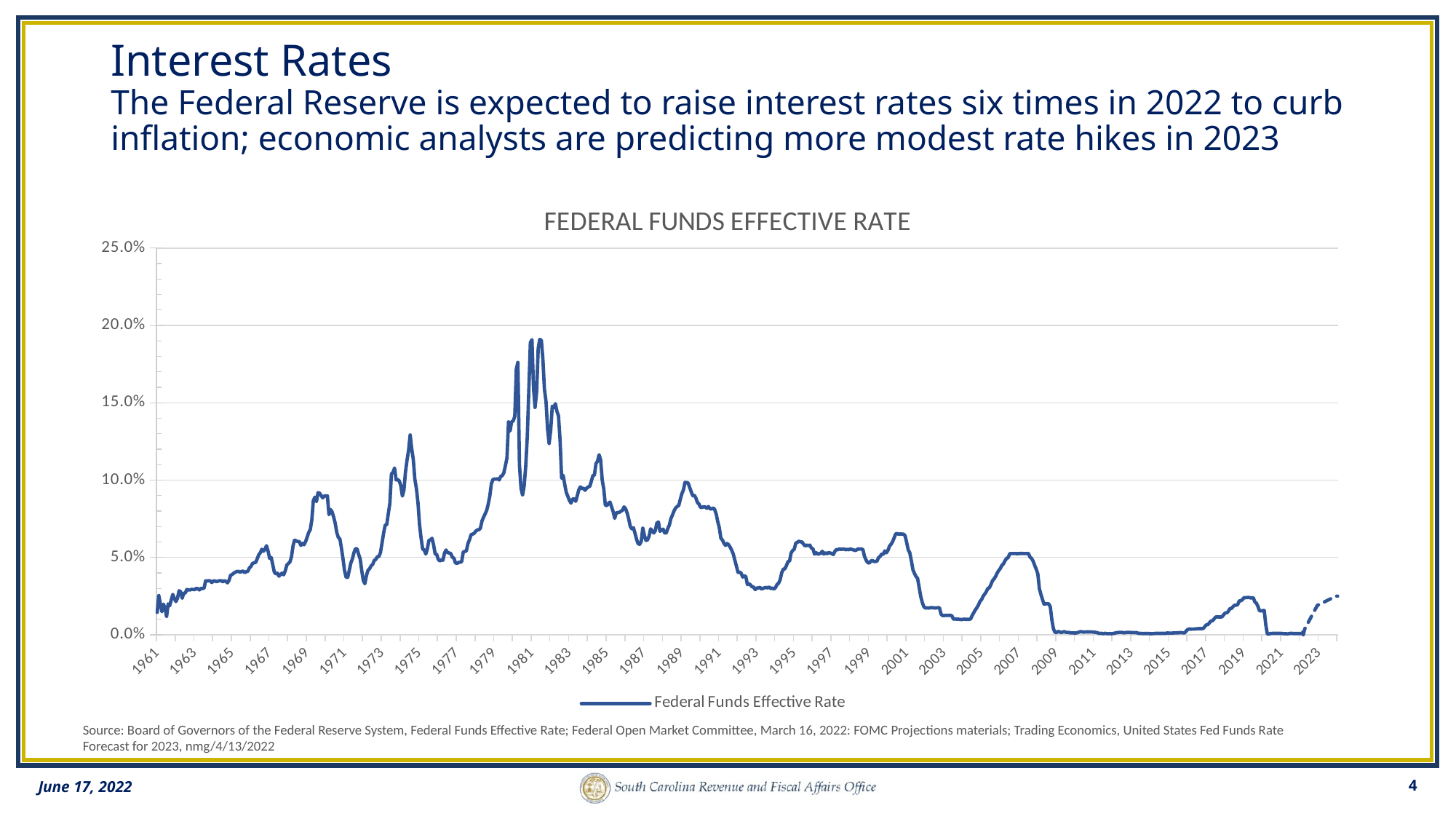
Around which year does the Federal Funds Effective Rate reach its highest value on the chart? 1981 Is the value of the Federal Funds Effective Rate around 1989 greater or less than 5.0%? greater Does the Federal Funds Effective Rate rise or fall between 2007 and 2009? fall Is the value of the Federal Funds Effective Rate around 2011 greater or less than 5.0%? less What kind of chart is shown on the slide? line chart Is the peak value of the Federal Funds Effective Rate around 1974 greater or less than 10.0%? greater Does the Federal Funds Effective Rate rise or fall between 2016 and 2019? rise How many series does the chart's legend list? 1 What is the name of the series shown in the legend? Federal Funds Effective Rate What is the title of the chart? FEDERAL FUNDS EFFECTIVE RATE